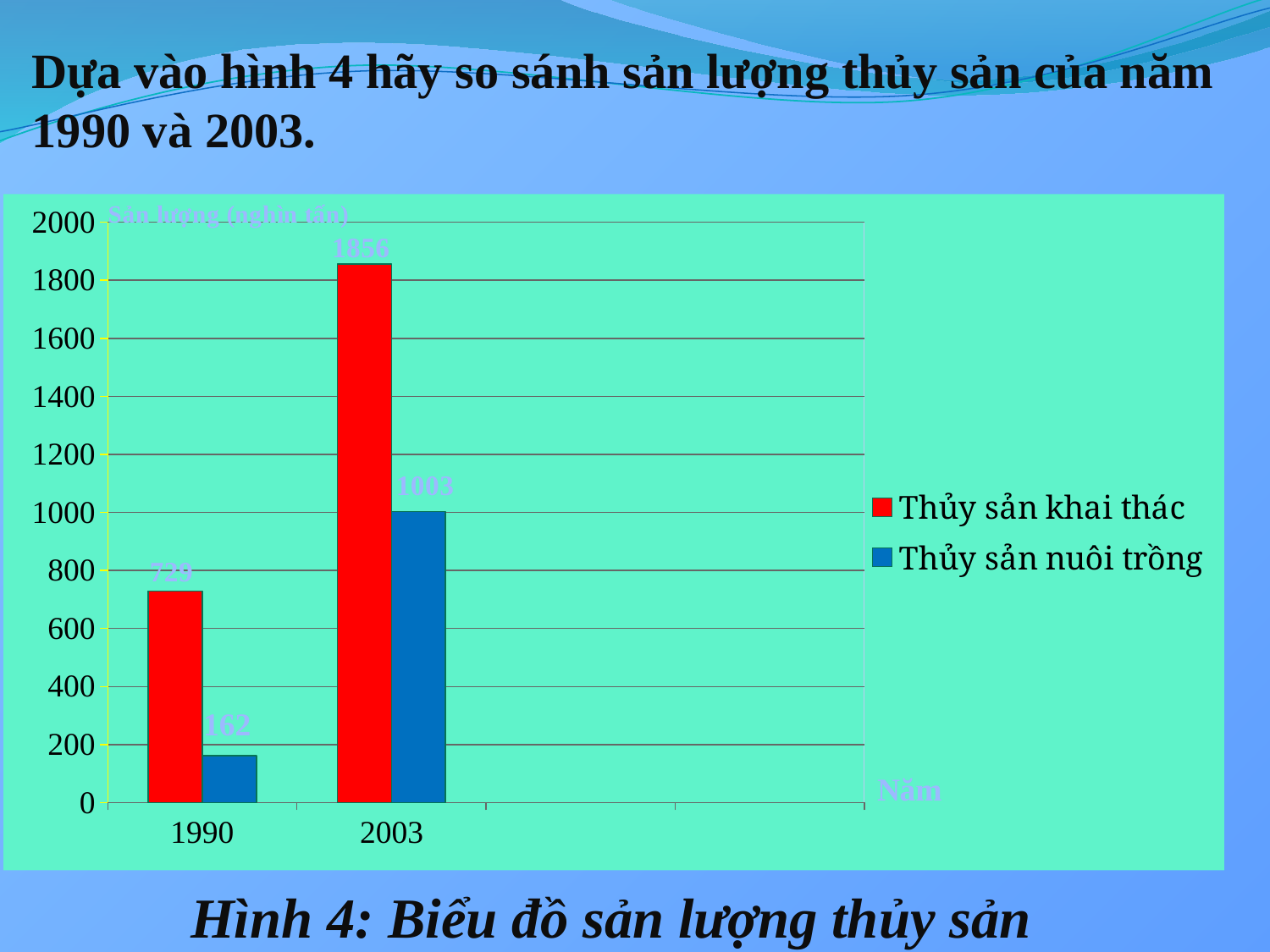
What is the value for Thủy sản nuôi trồng in 2003? 1003 Which year has the lowest value for Thủy sản nuôi trồng? 1990 How many series does the legend list? 2 Which colour represents Thủy sản nuôi trồng in the chart? Blue What is the value for Thủy sản khai thác in 2003? 1856 Which is larger in 1990: Thủy sản khai thác or Thủy sản nuôi trồng? Thủy sản khai thác What kind of chart is shown on the slide? Bar chart What is the value for Thủy sản khai thác in 1990? 729 Which year has the highest value for Thủy sản khai thác? 2003 What is the difference between Thủy sản khai thác and Thủy sản nuôi trồng in 2003? 853 What is the value for Thủy sản nuôi trồng in 1990? 162 What is the difference between Thủy sản khai thác in 2003 and in 1990? 1127